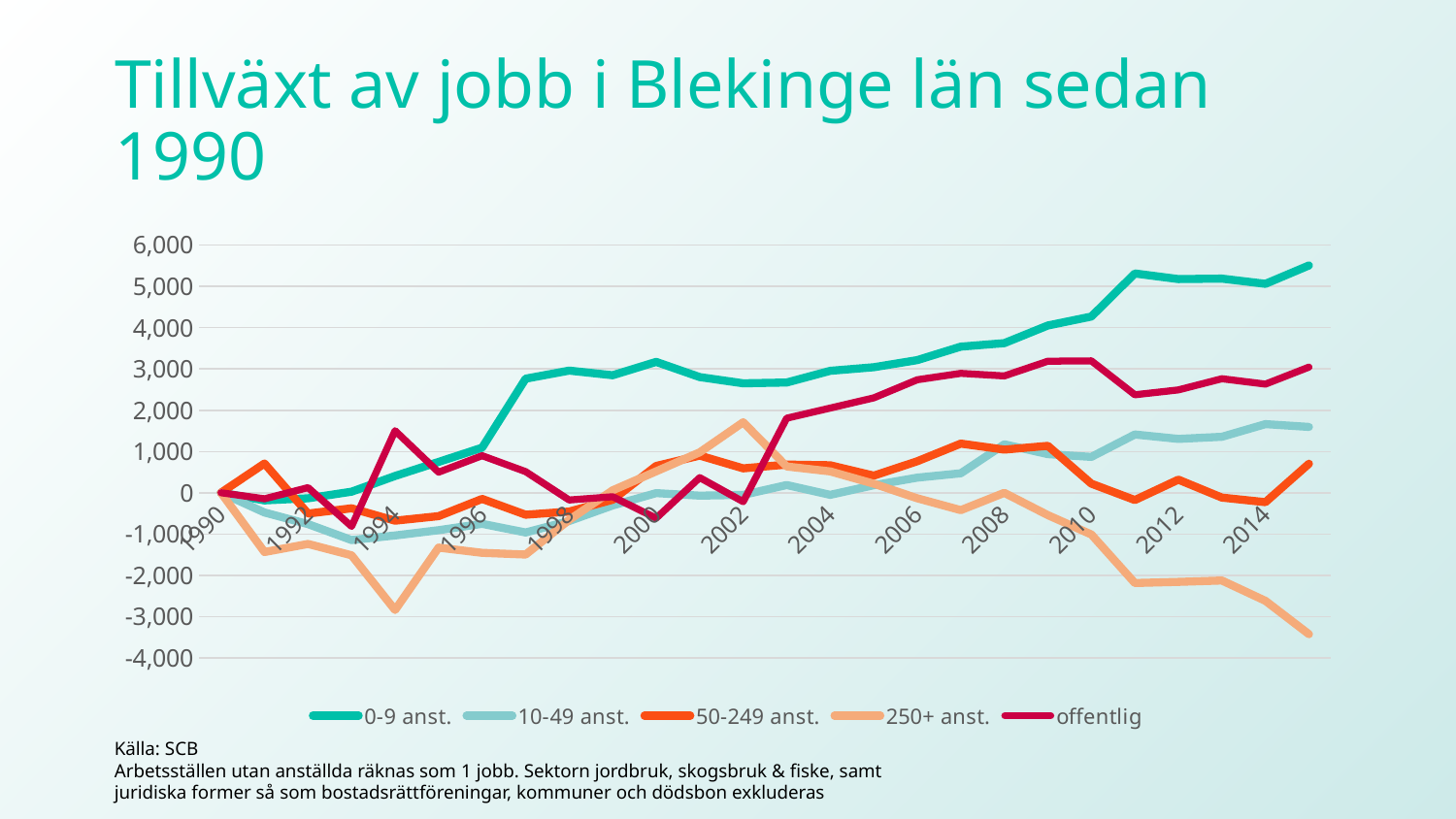
Which series has the lowest value at the right end of the chart (2015)? 250+ anst. Does the 250+ anst. series rise or fall overall from 2002 to the end of the chart? fall What kind of chart is shown on the slide? line chart Is the value for offentlig in 2010 greater or less than 2,000? greater Is the value for 250+ anst. at the right end of the chart greater or less than -3,000? less What is the value for 0-9 anst. in 1990? 0 Is the value for 250+ anst. in 1994 greater or less than -2,000? less Which series has the highest value at the right end of the chart (2015)? 0-9 anst. Does the 0-9 anst. series rise or fall overall from 1990 to the end of the chart? rise In 2014, which is larger: the value for offentlig or the value for 10-49 anst.? offentlig How many series does the legend list? 5